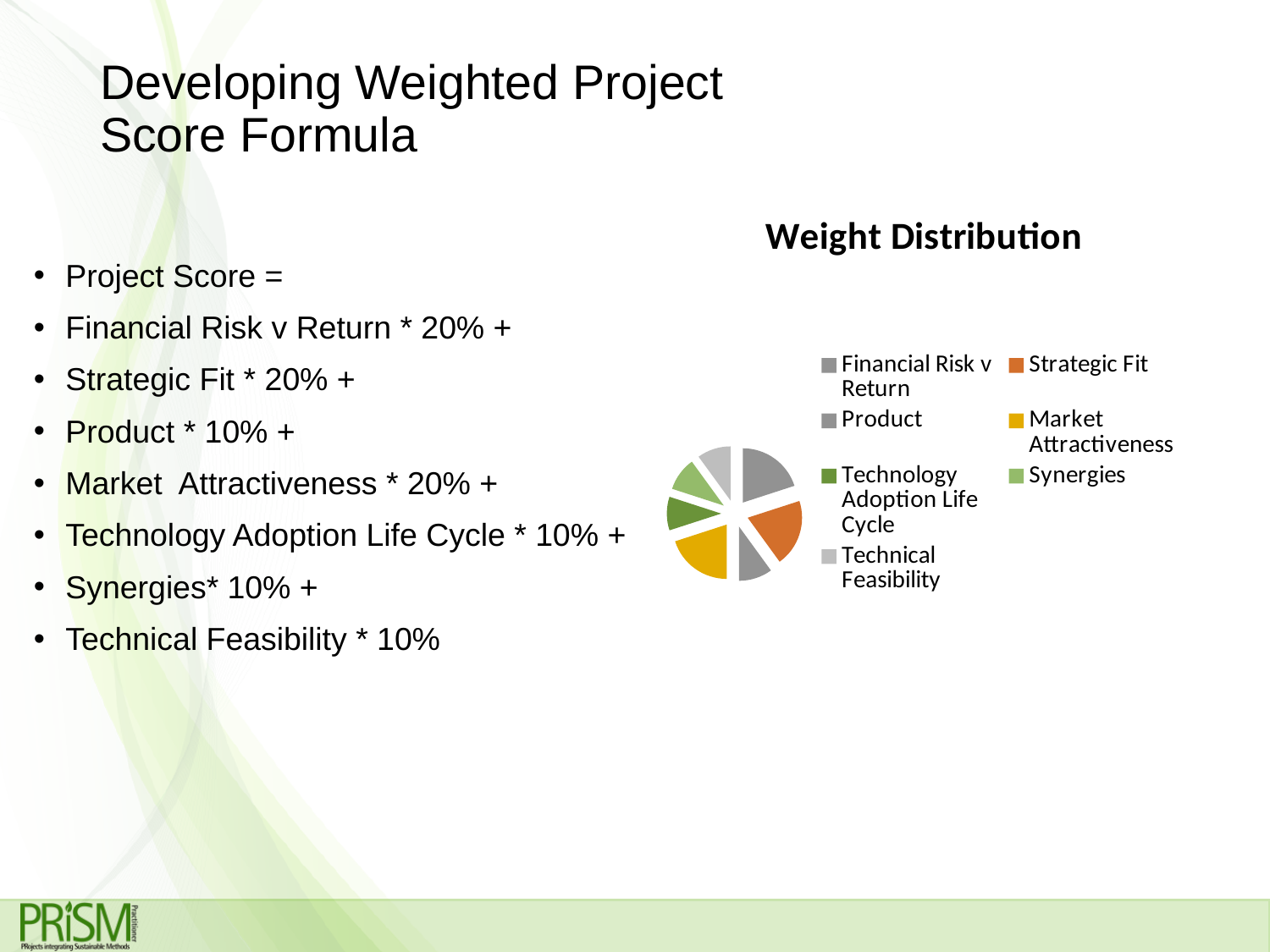
In the Weight Distribution pie chart, is the slice for Strategic Fit larger or smaller than the slice for Product? Larger In the Weight Distribution pie chart, is the slice for Financial Risk v Return larger or smaller than the slice for Technical Feasibility? Larger Is Technology Adoption Life Cycle one of the categories in the Weight Distribution pie chart? Yes What is the title of the chart on the slide? Weight Distribution In the Weight Distribution pie chart, which category is shown in orange? Strategic Fit In the Weight Distribution pie chart, is the slice for Synergies larger or smaller than the slice for Market Attractiveness? Smaller What kind of chart is shown on the slide? Pie chart How many categories does the legend of the Weight Distribution pie chart list? 7